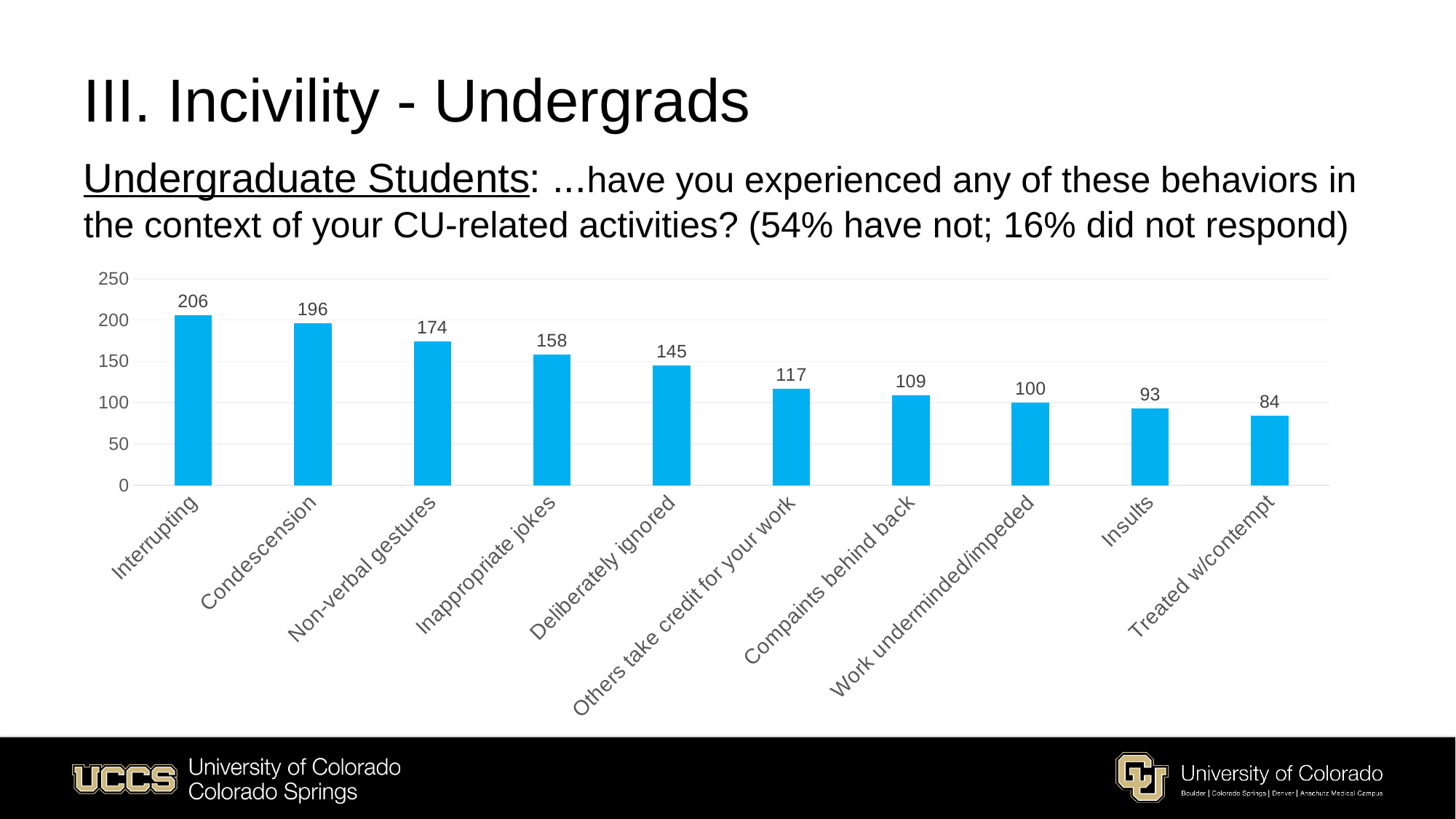
What is the difference between the values for Condescension and Non-verbal gestures? 22 What is the value for Insults? 93 Which is larger, the value for Inappropriate jokes or the value for Others take credit for your work? Inappropriate jokes Do the values rise or fall from left to right along the x axis? fall Which category has the lowest value? Treated w/contempt Which category has the highest value? Interrupting What is the value for Interrupting? 206 What is the value for Compaints behind back? 109 Is the value for Work underminded/impeded greater or less than 150? less How many categories are shown in the chart? 10 What kind of chart is shown on the slide? bar chart What is the value for Deliberately ignored? 145